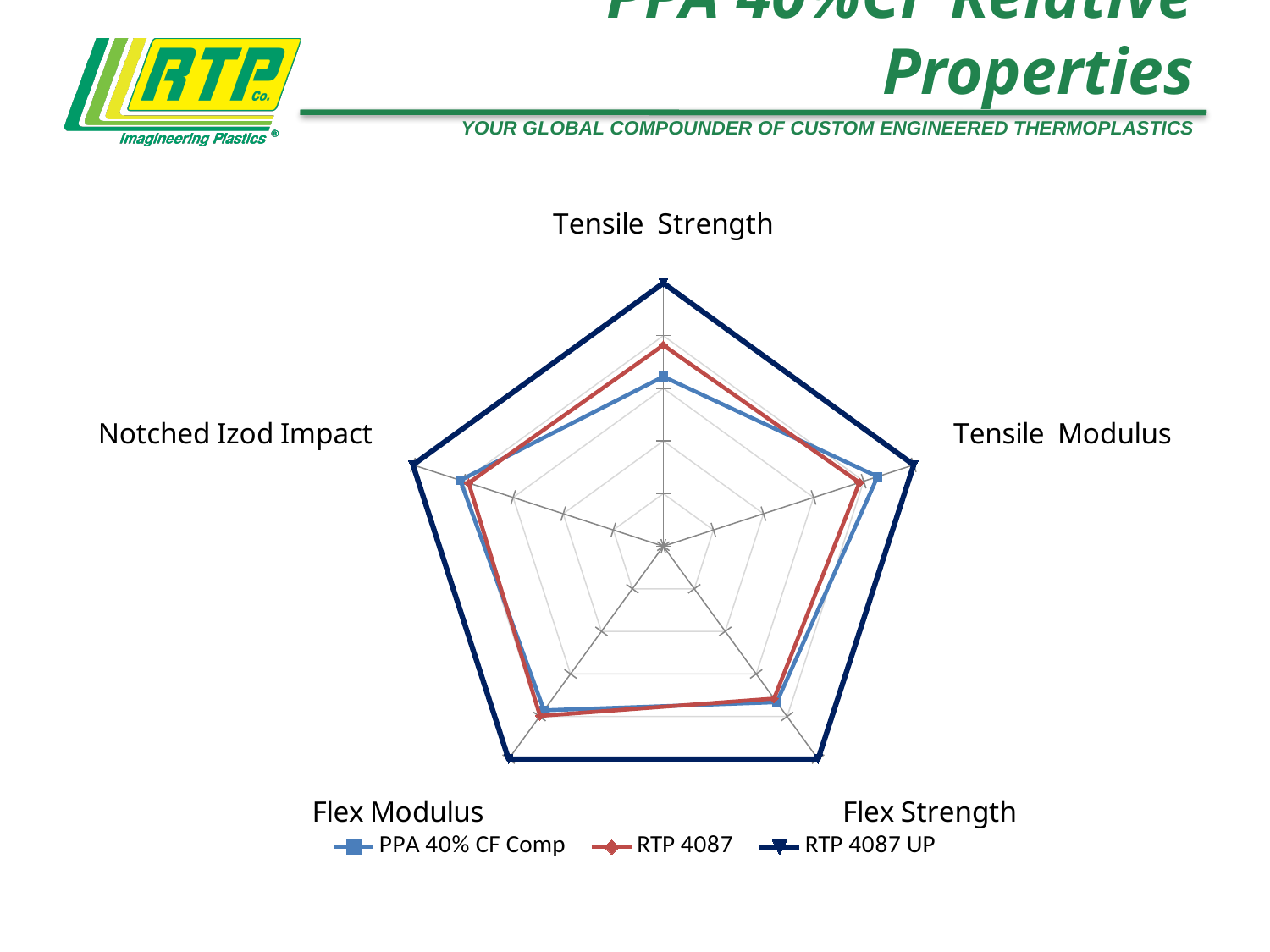
How many property categories (axes) does the radar chart have? 5 Which property label appears at the top of the radar chart? Tensile Strength For Tensile Strength, which series has the lowest value? PPA 40% CF Comp How many series does the legend list? 3 Which series is plotted on the outermost pentagon of the radar chart? RTP 4087 UP For Tensile Strength, which is larger: RTP 4087 or PPA 40% CF Comp? RTP 4087 On which axis does the RTP 4087 series have its lowest relative value? Flex Strength Which series is drawn in red in the legend? RTP 4087 What kind of chart is shown on the slide? Radar chart On which axis does the PPA 40% CF Comp series have its lowest relative value? Tensile Strength For Tensile Strength, which series has the highest value? RTP 4087 UP